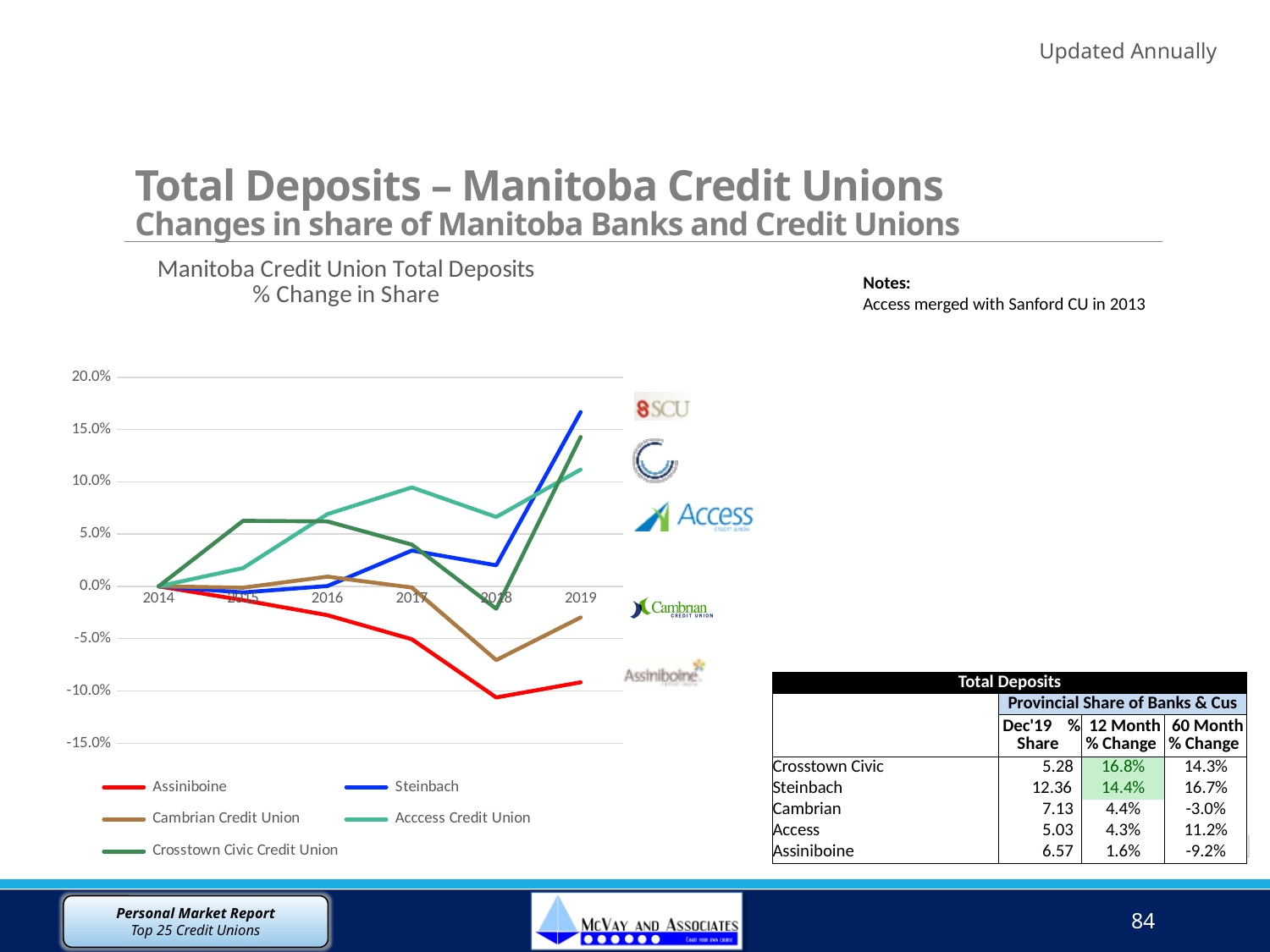
Which credit union has the highest % change in share in 2017? Acccess Credit Union How many series does the chart legend list? 5 How many years are plotted along the x axis of the chart? 6 Is the value for Assiniboine in 2018 greater or less than -5.0%? less Is the value for Acccess Credit Union in 2017 greater or less than 5.0%? greater Does the Assiniboine line rise or fall from 2014 to 2018? fall Which credit union has the lowest % change in share in 2019? Assiniboine What colour is the Assiniboine line in the chart? red Is the value for Steinbach in 2019 greater or less than 15.0%? greater In 2016, which is larger: the value for Acccess Credit Union or for Cambrian Credit Union? Acccess Credit Union Which credit union has the highest % change in share in 2019? Steinbach What kind of chart is shown on the slide? line chart